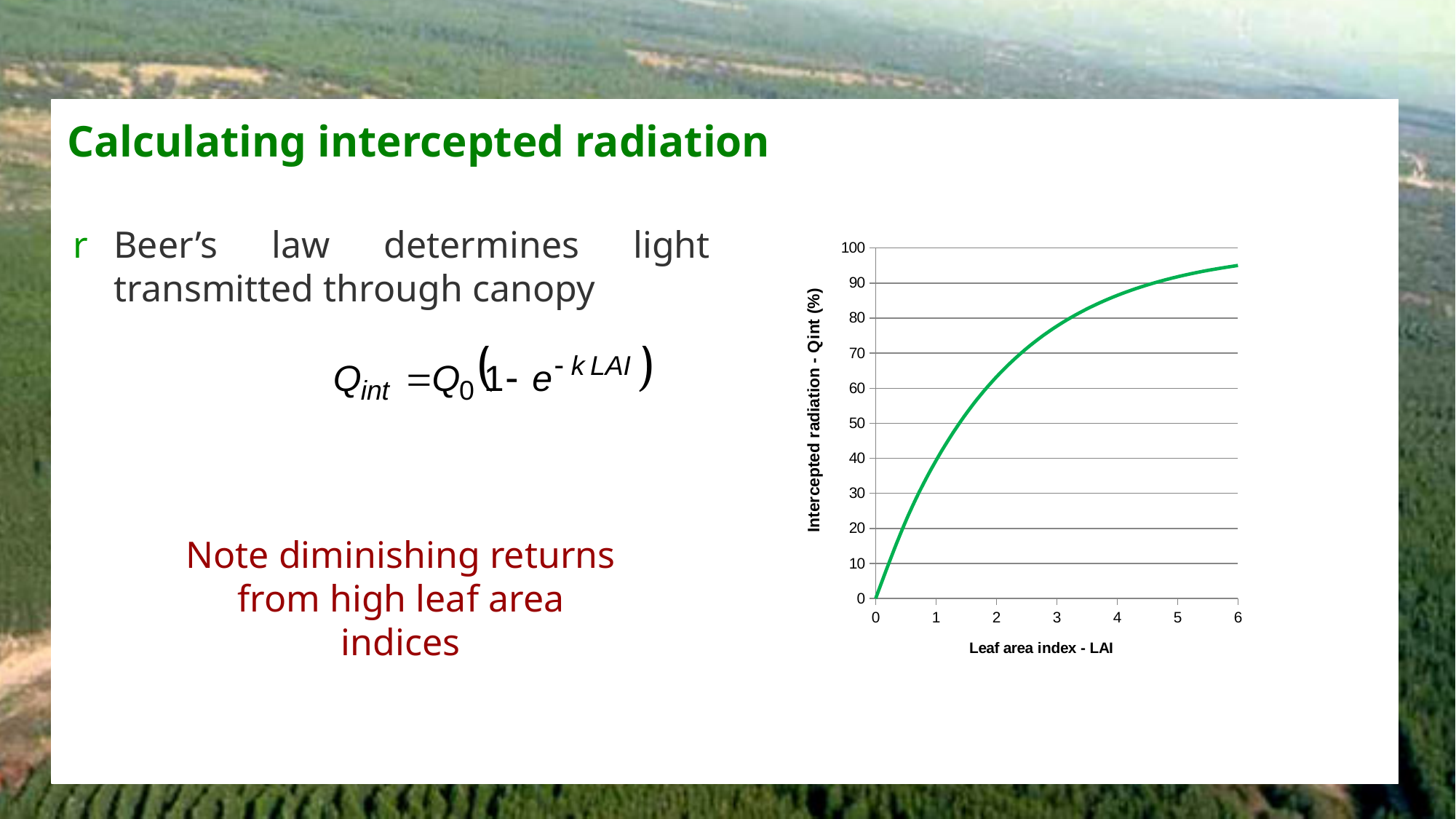
Is the intercepted radiation at a leaf area index of 2 greater or less than 50? greater What is the intercepted radiation (Qint) when the leaf area index is 0? 0 Does intercepted radiation rise or fall as leaf area index increases along the x axis? rises What is the title of the x axis of the chart? Leaf area index - LAI Is the intercepted radiation at a leaf area index of 6 greater or less than 100? less Is the intercepted radiation at a leaf area index of 5 greater or less than 80? greater At which leaf area index shown on the x axis is intercepted radiation lowest? 0 What kind of chart is shown on the slide? line chart At which leaf area index shown on the x axis is intercepted radiation highest? 6 What is the title of the y axis of the chart? Intercepted radiation - Qint (%)